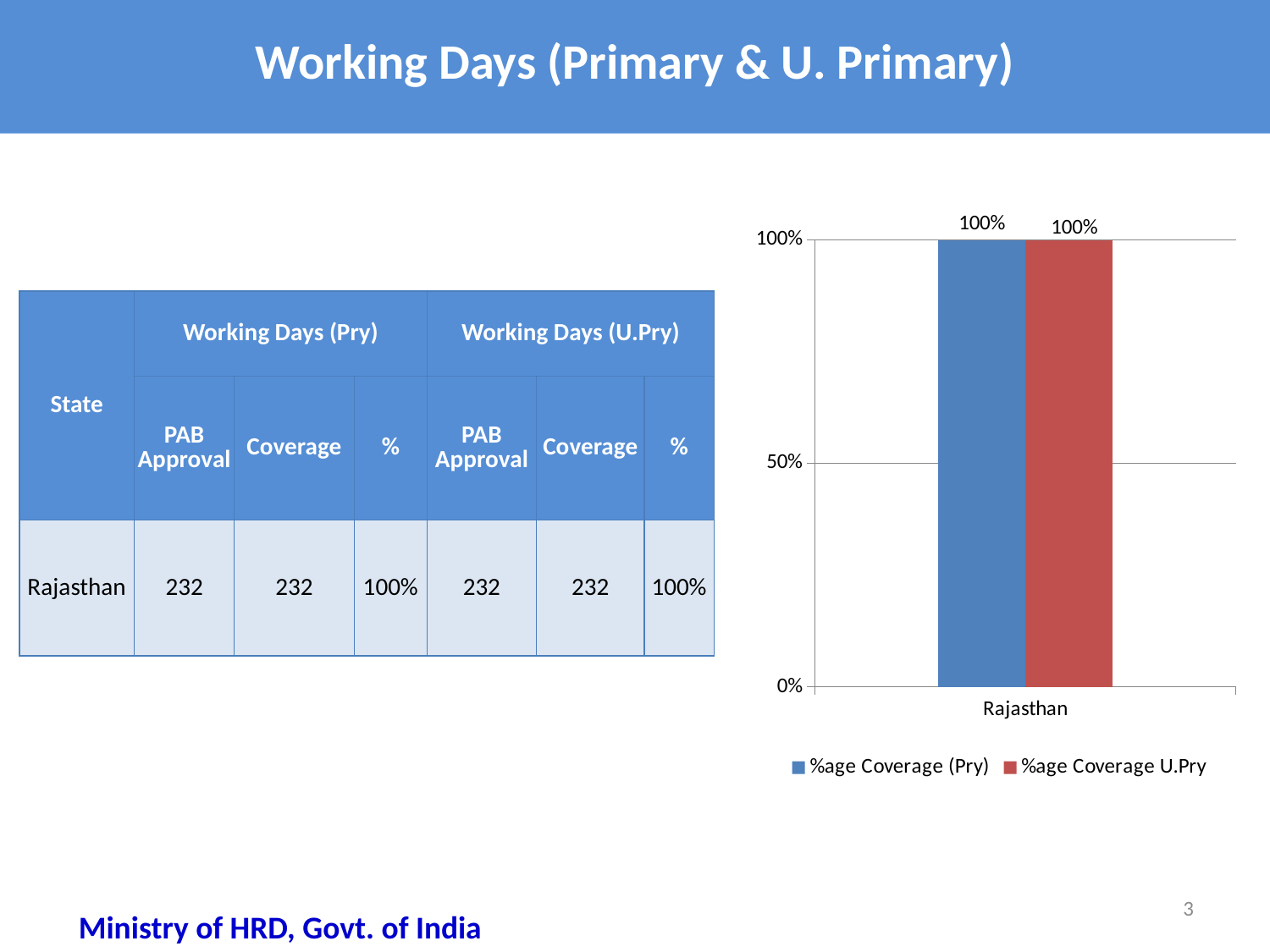
What is the difference between %age Coverage (Pry) and %age Coverage U.Pry for Rajasthan? 0% What is the value of %age Coverage (Pry) for Rajasthan? 100% Which series is shown in red in the chart? %age Coverage U.Pry What is the value of %age Coverage U.Pry for Rajasthan? 100% Is the value of %age Coverage U.Pry for Rajasthan greater or less than 50%? greater Is the value of %age Coverage (Pry) for Rajasthan greater or less than 50%? greater How many series does the chart's legend list? 2 What kind of chart is shown on the slide? Bar chart Which state is shown on the x axis of the chart? Rajasthan How many categories are shown on the x axis of the chart? 1